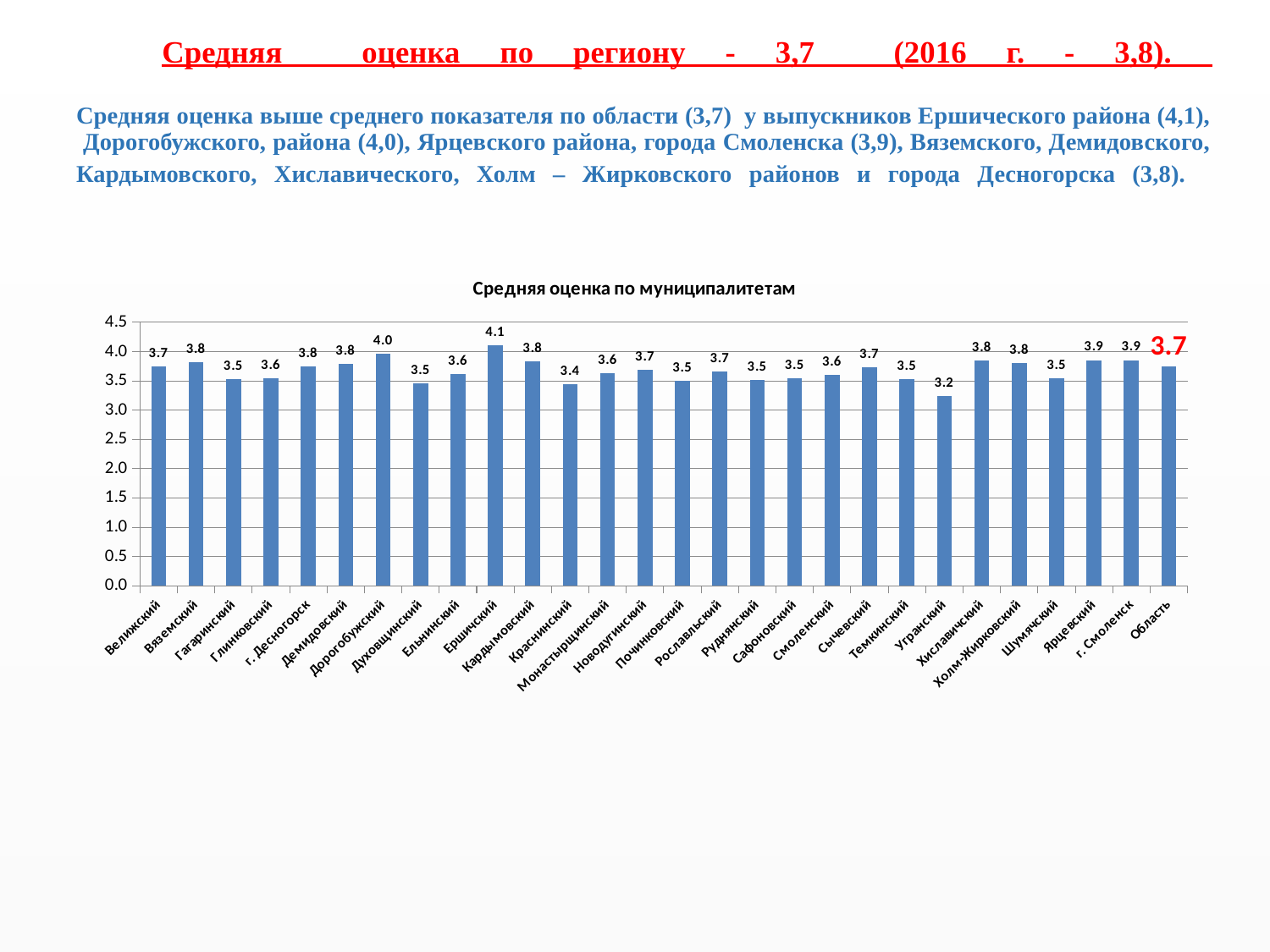
What is the value shown for Угранский? 3.2 What is the difference between the values for Дорогобужский and Краснинский? 0.6 What type of chart is shown on the slide? Bar chart What is the average score for Ершичский in the chart 'Средняя оценка по муниципалитетам'? 4.1 What is the difference between the values for Ершичский and Угранский? 0.9 How many bars (categories) are shown in the chart? 28 Which has a higher value, Ярцевский or Гагаринский? Ярцевский Which municipality has the highest average score? Ершичский What is the value shown for Дорогобужский? 4.0 Which municipality has the lowest average score? Угранский What is the value shown for Область (the last bar)? 3.7 Is the value for Угранский greater or less than 3.5? less